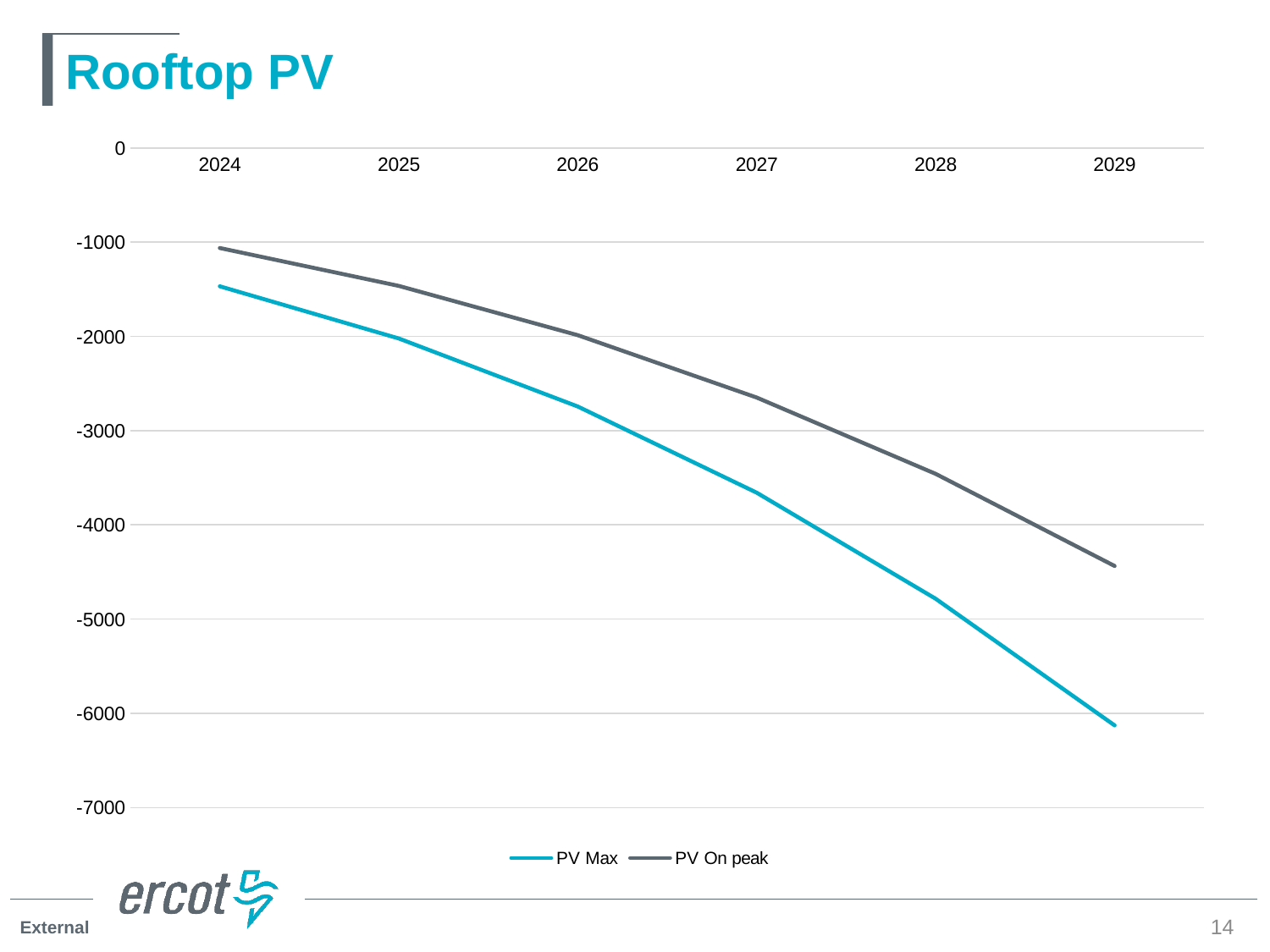
What is the title of the slide containing the chart? Rooftop PV How many years are plotted along the x axis? 6 Is the value for PV Max in 2029 greater or less than -5000? less Is the value for PV On peak in 2029 greater or less than -4000? less Is the value for PV Max in 2024 greater or less than -1000? less How many series does the legend list? 2 What kind of chart is shown on the slide? line chart Do the values for PV Max rise or fall from 2024 to 2029? fall Do the values for PV On peak rise or fall from 2024 to 2029? fall In 2029, which series has the higher value, PV Max or PV On peak? PV On peak